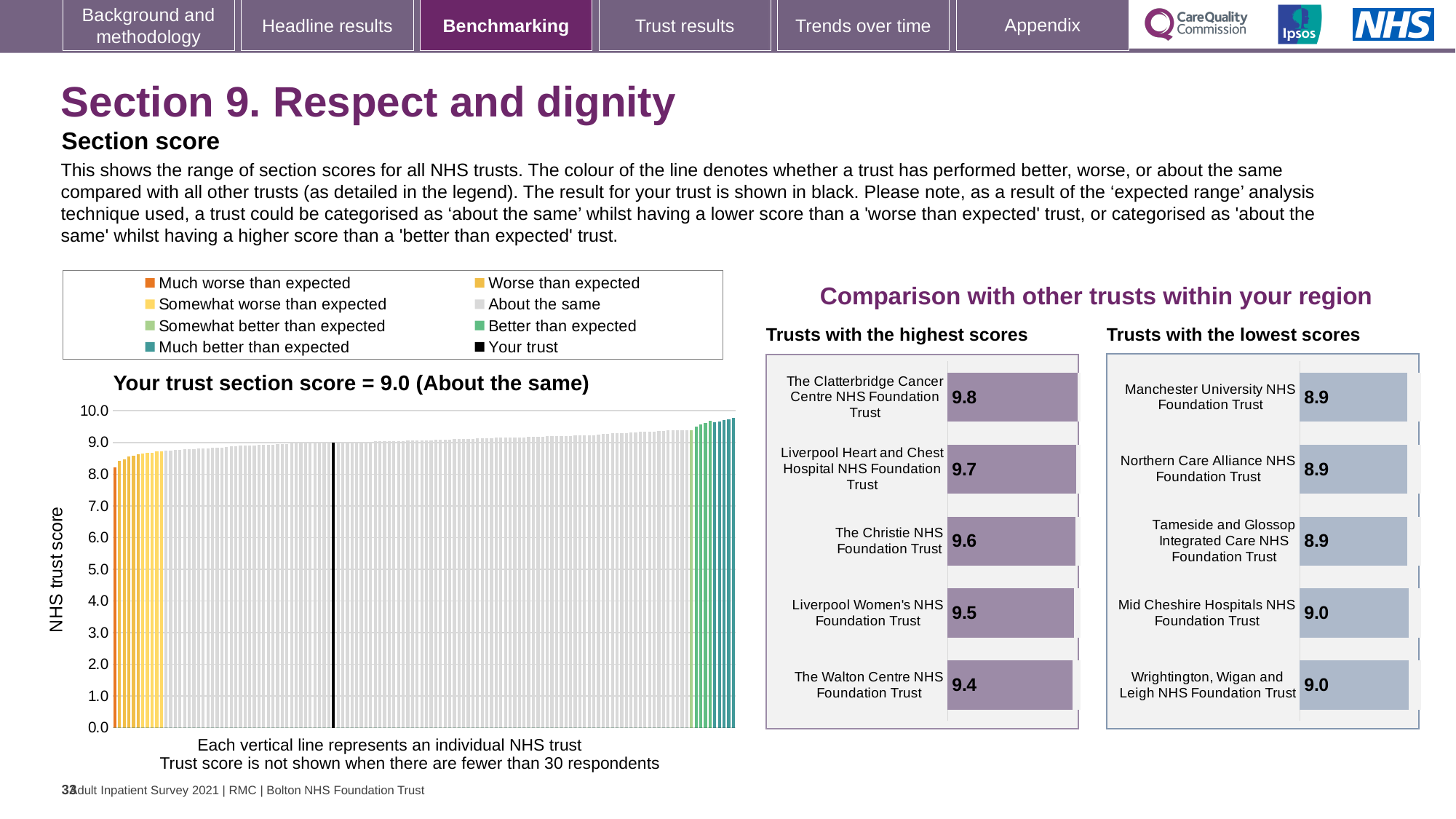
In the 'Trusts with the lowest scores' chart, what is the score for Mid Cheshire Hospitals NHS Foundation Trust? 9.0 In the 'Your trust section score' chart, is the value of the leftmost bar greater or less than 9.0? less In the 'Trusts with the highest scores' chart, which has the higher score: The Christie NHS Foundation Trust or Liverpool Women's NHS Foundation Trust? The Christie NHS Foundation Trust In the 'Trusts with the highest scores' chart, what is the score for The Clatterbridge Cancer Centre NHS Foundation Trust? 9.8 How many entries does the legend above the 'Your trust section score' chart list? 8 In the 'Trusts with the highest scores' chart, what is the difference between the scores of The Clatterbridge Cancer Centre NHS Foundation Trust and The Walton Centre NHS Foundation Trust? 0.4 In the 'Your trust section score' chart, what is the section score for your trust? 9.0 In the 'Trusts with the highest scores' chart, which trust has the lowest score? The Walton Centre NHS Foundation Trust What kind of chart is the 'Your trust section score' chart on the left of the slide? bar chart In the 'Your trust section score' chart, do the trust scores rise or fall from left to right along the x axis? rise What is the label on the vertical axis of the 'Your trust section score' chart? NHS trust score How many trusts are shown in the 'Trusts with the lowest scores' chart? 5